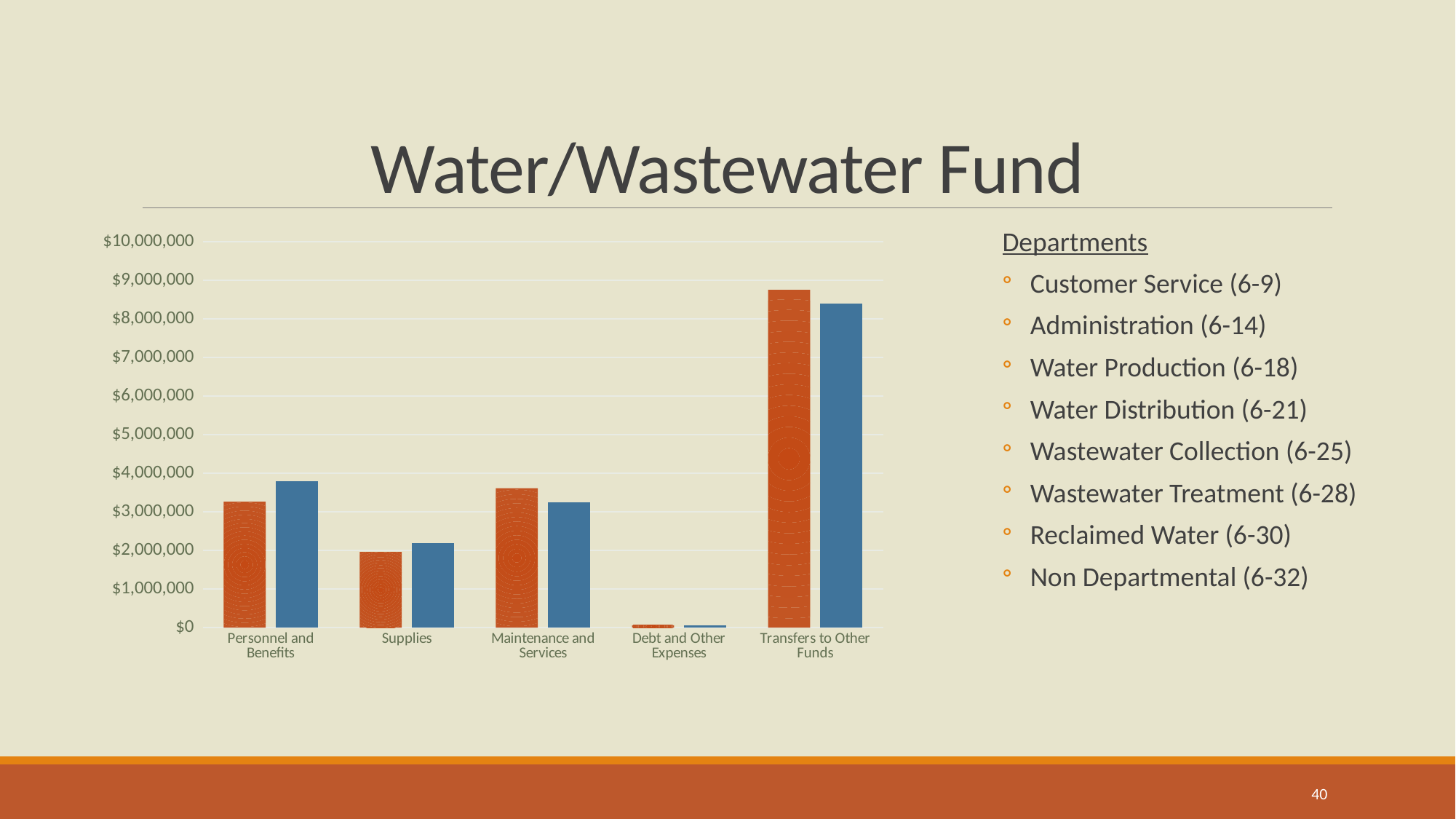
What kind of chart is shown on the slide? bar chart For Maintenance and Services, which bar is taller, the orange one or the blue one? the orange one Is the blue bar for Supplies greater or less than $3,000,000? less Which category has the shortest bars in the chart? Debt and Other Expenses Which category has the tallest bars in the chart? Transfers to Other Funds Which category has a larger orange bar, Supplies or Maintenance and Services? Maintenance and Services How many categories are shown on the x axis of the chart? 5 What is the title of the slide containing the chart? Water/Wastewater Fund For Personnel and Benefits, which bar is taller, the orange one or the blue one? the blue one Is the orange bar for Personnel and Benefits greater or less than $3,000,000? greater Is the blue bar for Debt and Other Expenses greater or less than $1,000,000? less